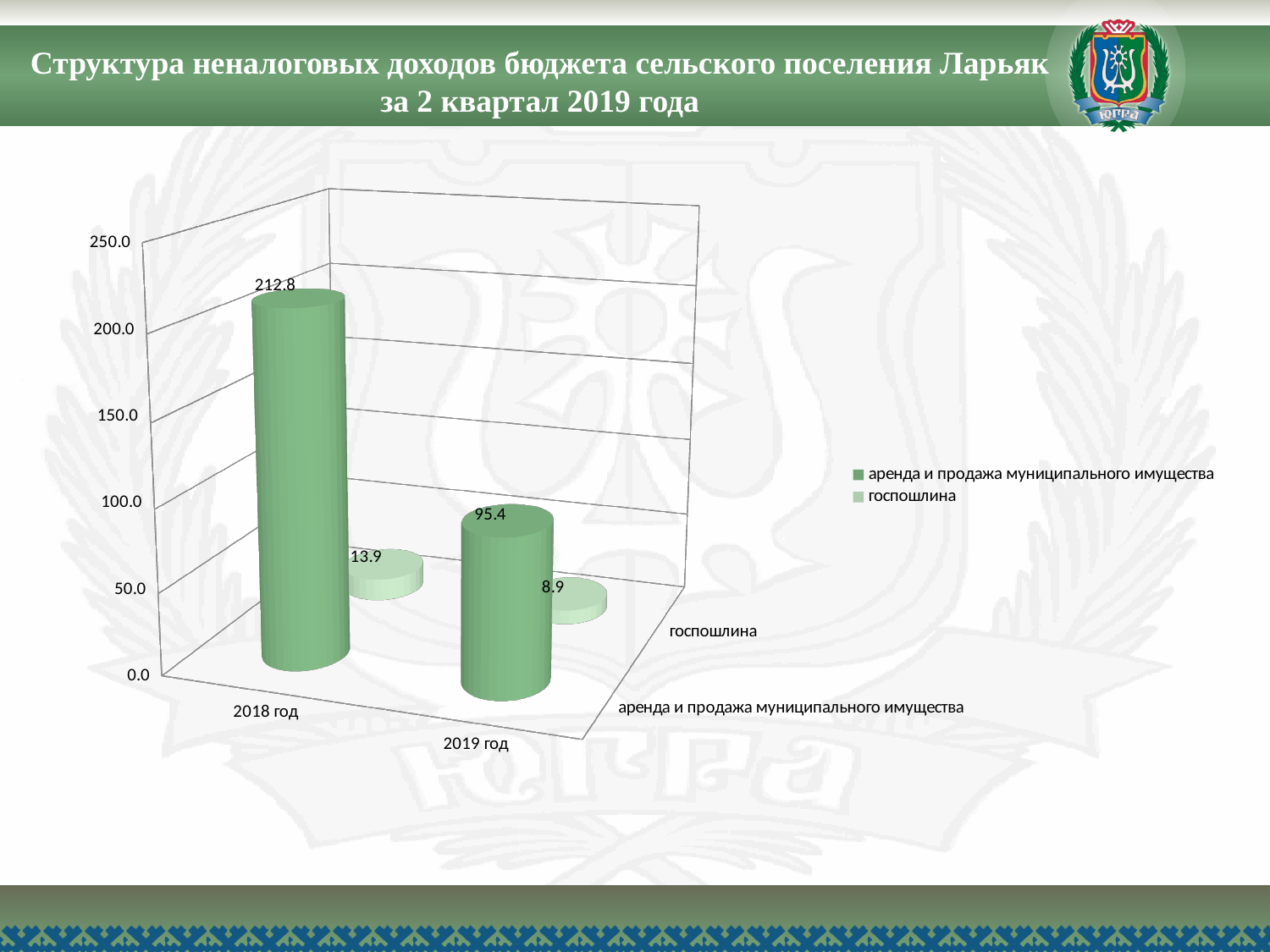
By how much did аренда и продажа муниципального имущества decrease from 2018 год to 2019 год? 117.4 What is the value for госпошлина in 2019 год? 8.9 What is the value for аренда и продажа муниципального имущества in 2019 год? 95.4 Is the value for аренда и продажа муниципального имущества in 2019 год greater or less than 100.0? less Do the values for both series rise or fall from 2018 год to 2019 год? fall What kind of chart is shown on the slide? bar chart How many series does the legend list? 2 Which year has the lower value for госпошлина? 2019 год What is the difference between госпошлина in 2018 год and in 2019 год? 5.0 What is the value for аренда и продажа муниципального имущества in 2018 год? 212.8 Which year has the higher value for аренда и продажа муниципального имущества? 2018 год What is the value for госпошлина in 2018 год? 13.9